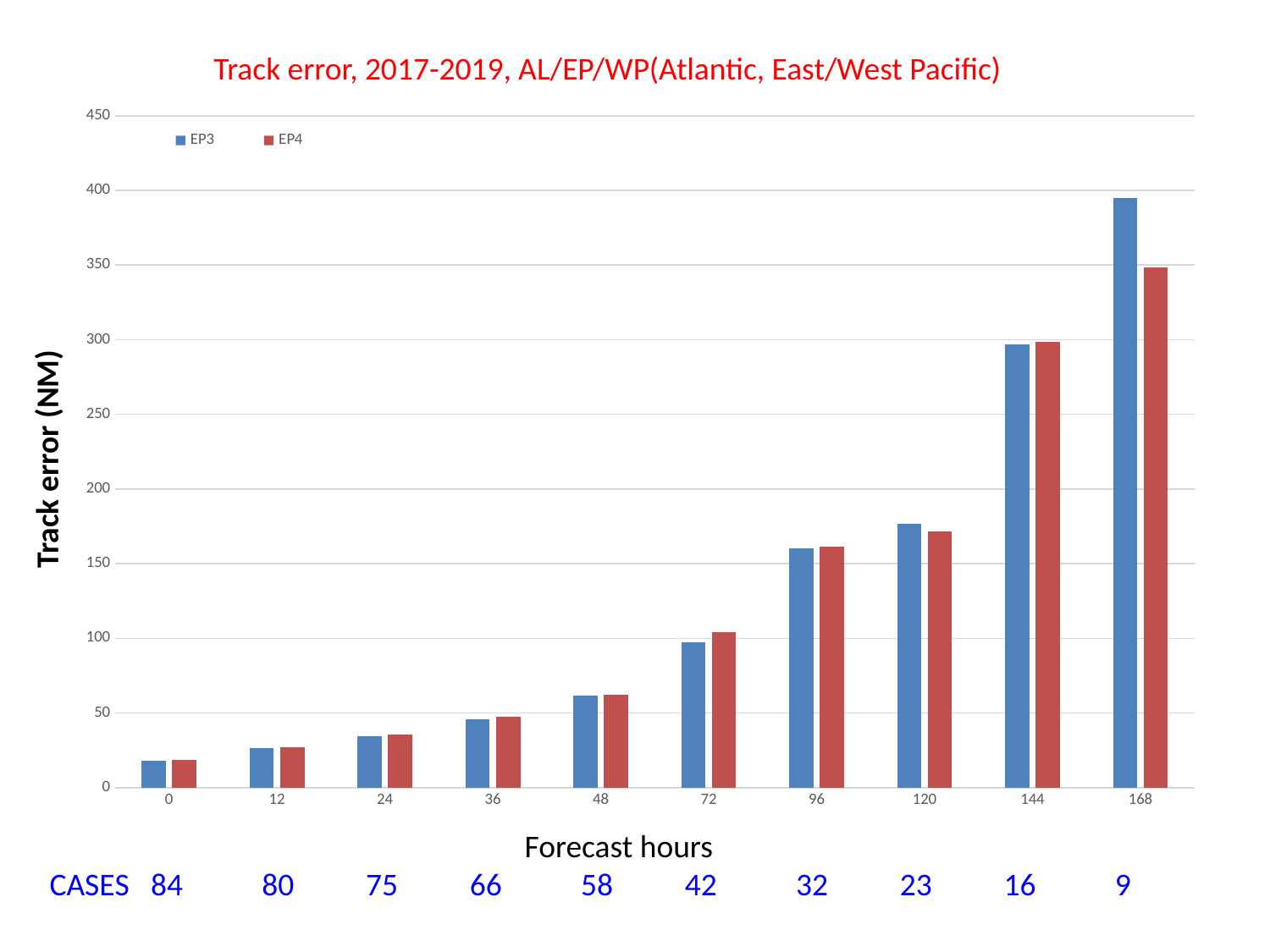
How many forecast-hour categories are shown on the x axis? 10 Is the EP3 track error at 168 forecast hours greater or less than 350? greater Is the EP3 track error at 96 forecast hours greater or less than 150? greater At 168 forecast hours, which series has the larger track error, EP3 or EP4? EP3 At which forecast hour is the EP3 track error highest? 168 Do the track error values rise or fall as forecast hours increase? rise How many series does the legend list? 2 Is the EP4 track error at 168 forecast hours greater or less than 300? greater At 72 forecast hours, which series has the larger track error, EP3 or EP4? EP4 What kind of chart is shown on the slide? bar chart What is the label on the y axis of the chart? Track error (NM) At which forecast hour is the EP4 track error lowest? 0